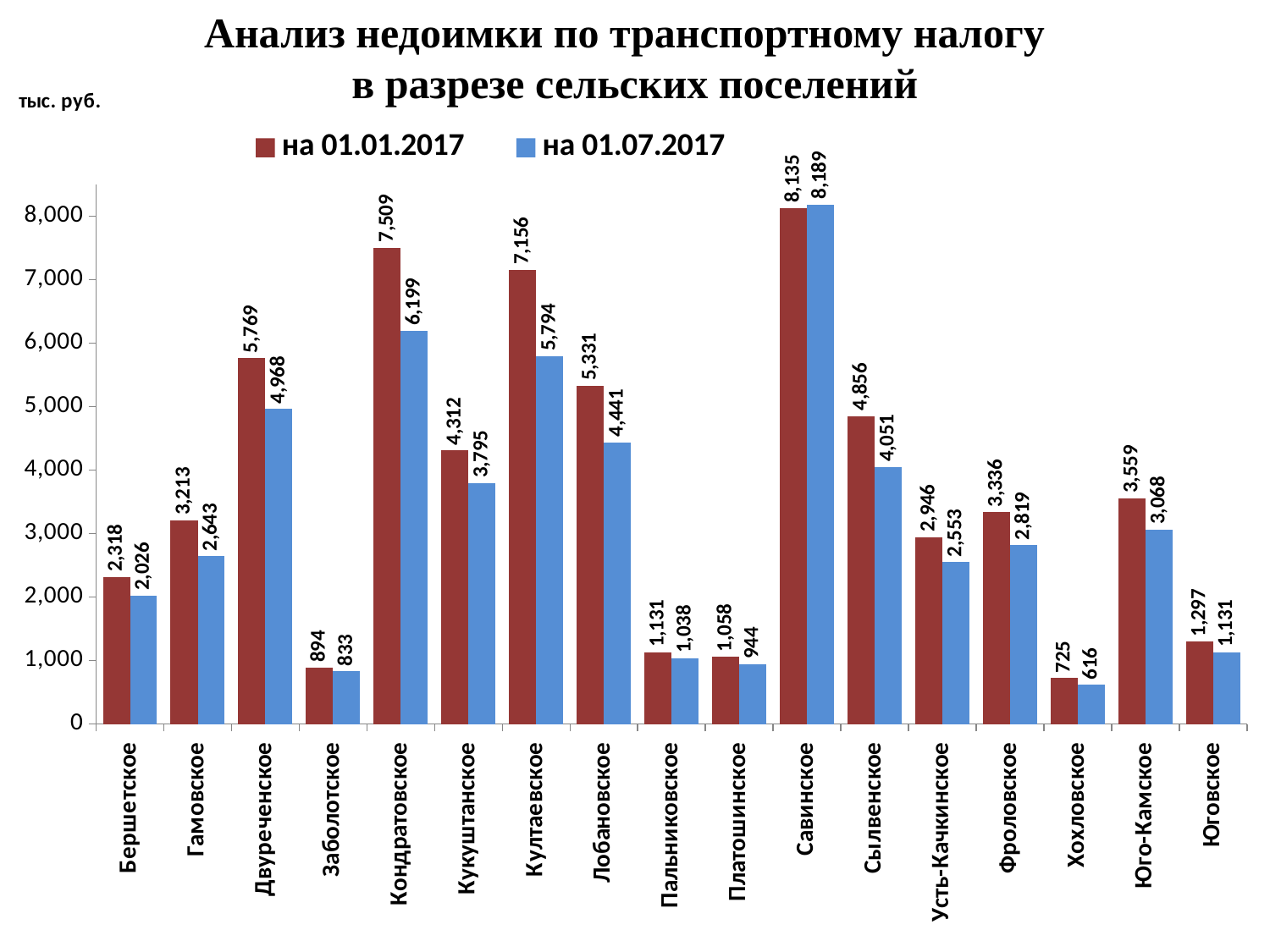
What kind of chart is shown on the slide? Bar chart Which settlement has the highest value in the series на 01.01.2017? Савинское How many settlements are shown on the x axis? 17 What is the value for Кондратовское in the series на 01.01.2017? 7,509 What unit of measurement is indicated in the top-left corner of the chart? тыс. руб. What is the value for Хохловское in the series на 01.07.2017? 616 Is the value for Кукуштанское in the series на 01.07.2017 greater or less than 4,000? less What is the value for Савинское in the series на 01.07.2017? 8,189 Which settlement has the lowest value in the series на 01.07.2017? Хохловское What is the difference between the на 01.01.2017 and на 01.07.2017 values for Кондратовское? 1,310 Which is larger in the series на 01.01.2017: Двуреченское or Лобановское? Двуреченское How many series does the legend list? 2